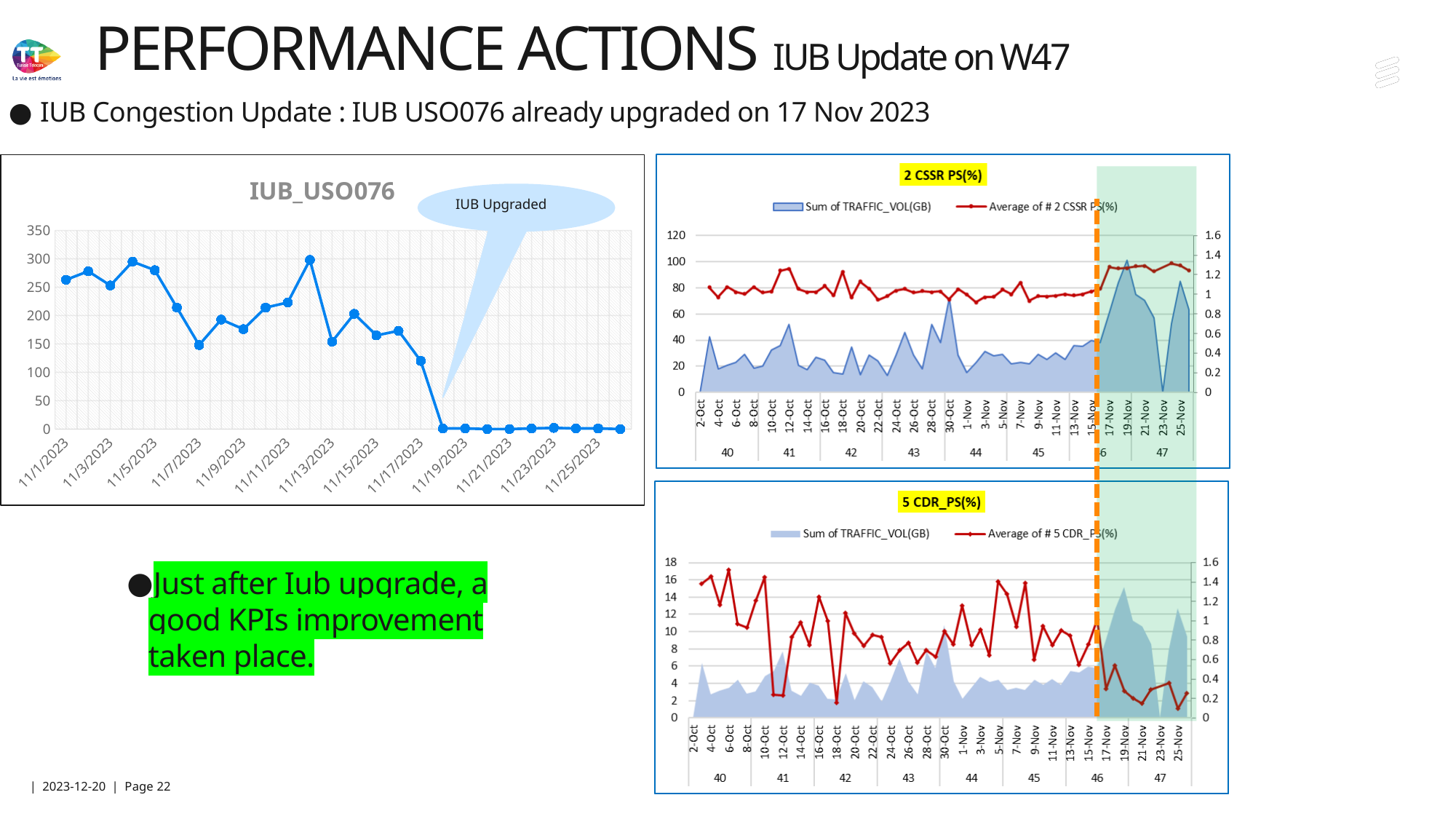
How many series does the legend of the 2 CSSR PS(%) chart list? 2 What are the two legend entries of the 5 CDR_PS(%) chart? Sum of TRAFFIC_VOL(GB) and Average of # 5 CDR_PS(%) In the IUB_USO076 chart, is the value for 11/13/2023 greater or less than 250? less In the 2 CSSR PS(%) chart, what is the highest value shown on the left vertical axis? 120 In the IUB_USO076 chart, which is larger, the value for 11/1/2023 or the value for 11/17/2023? 11/1/2023 In the IUB_USO076 chart, do the values overall rise or fall from 11/1/2023 to 11/25/2023? fall In the IUB_USO076 chart, is the value for 11/17/2023 greater or less than 150? less What does the callout on the IUB_USO076 chart say? IUB Upgraded In the IUB_USO076 chart, is the value for 11/1/2023 greater or less than 250? greater What kind of chart is the IUB_USO076 chart on the left of the slide? line chart